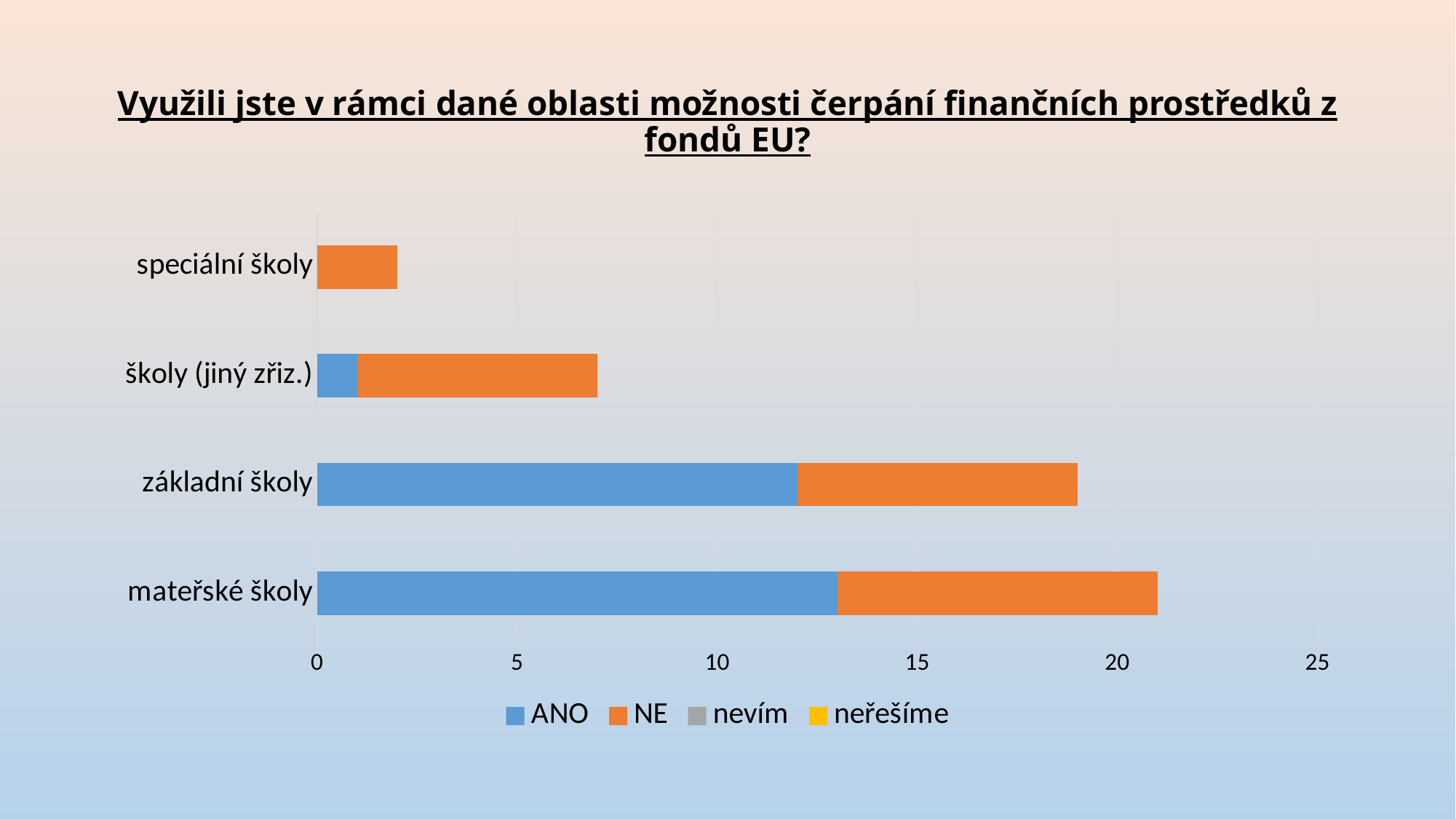
Is the total bar length for školy (jiný zřiz.) greater or less than 5? greater Which has the longer total bar, mateřské školy or základní školy? mateřské školy How many series does the legend list? 4 Which category shows only a NE segment and no ANO segment? speciální školy How many categories are shown on the chart? 4 Is the ANO value for základní školy greater or less than 10? greater What kind of chart is shown on the slide? bar chart Is the total bar length for speciální školy greater or less than 5? less Which category has the shortest total bar? speciální školy Which category has the longest total bar? mateřské školy